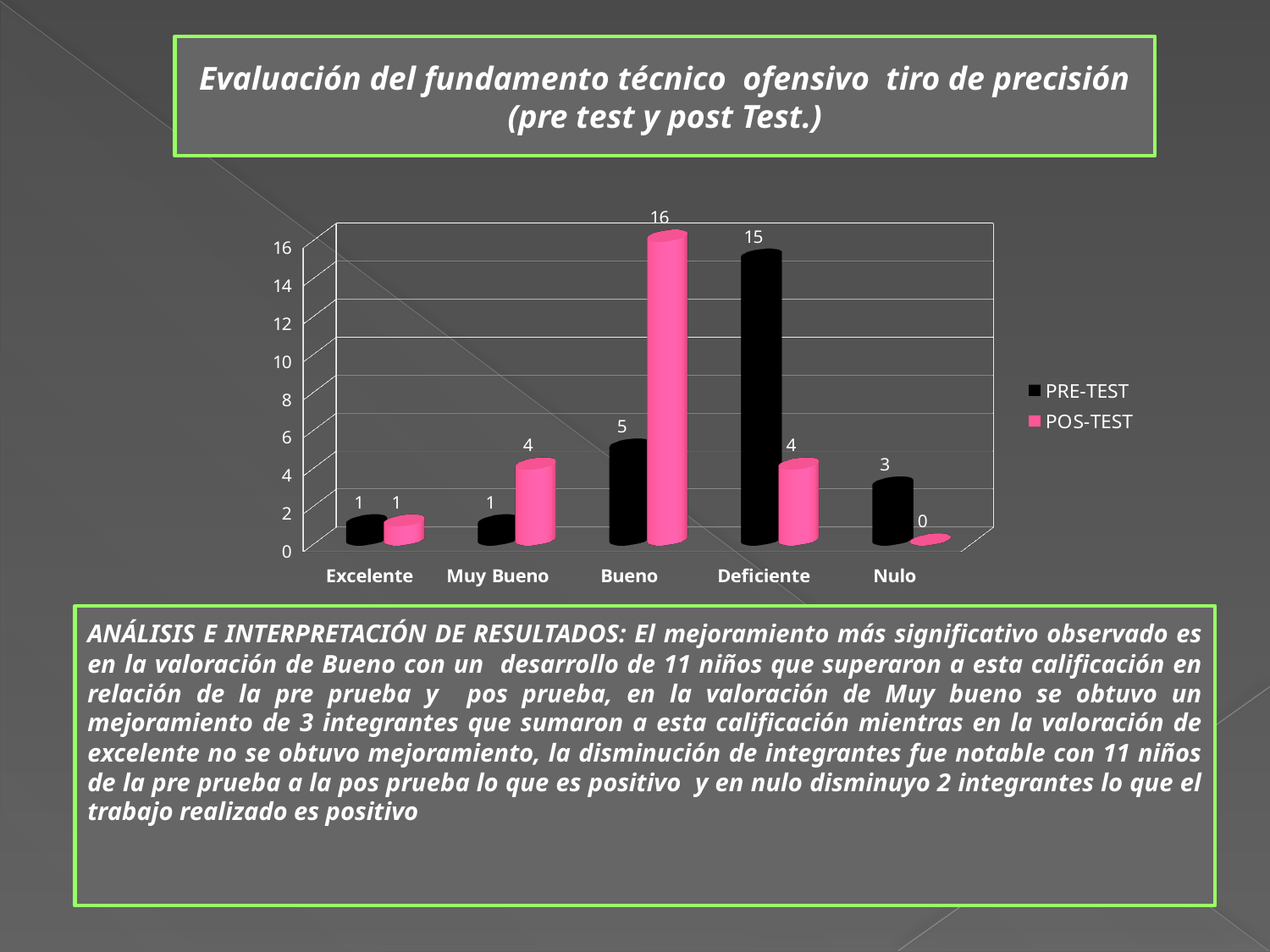
How many series does the legend list? 2 What is the difference between the POS-TEST and PRE-TEST values for Bueno? 11 What kind of chart is shown on the slide? Bar chart What is the POS-TEST value for Bueno? 16 What is the PRE-TEST value for Nulo? 3 What is the POS-TEST value for Muy Bueno? 4 Which is larger for Muy Bueno, the PRE-TEST value or the POS-TEST value? POS-TEST What is the difference between the PRE-TEST and POS-TEST values for Deficiente? 11 Which category has the highest PRE-TEST value? Deficiente What is the PRE-TEST value for Deficiente? 15 Which category has the lowest POS-TEST value? Nulo How many categories are shown on the x axis? 5